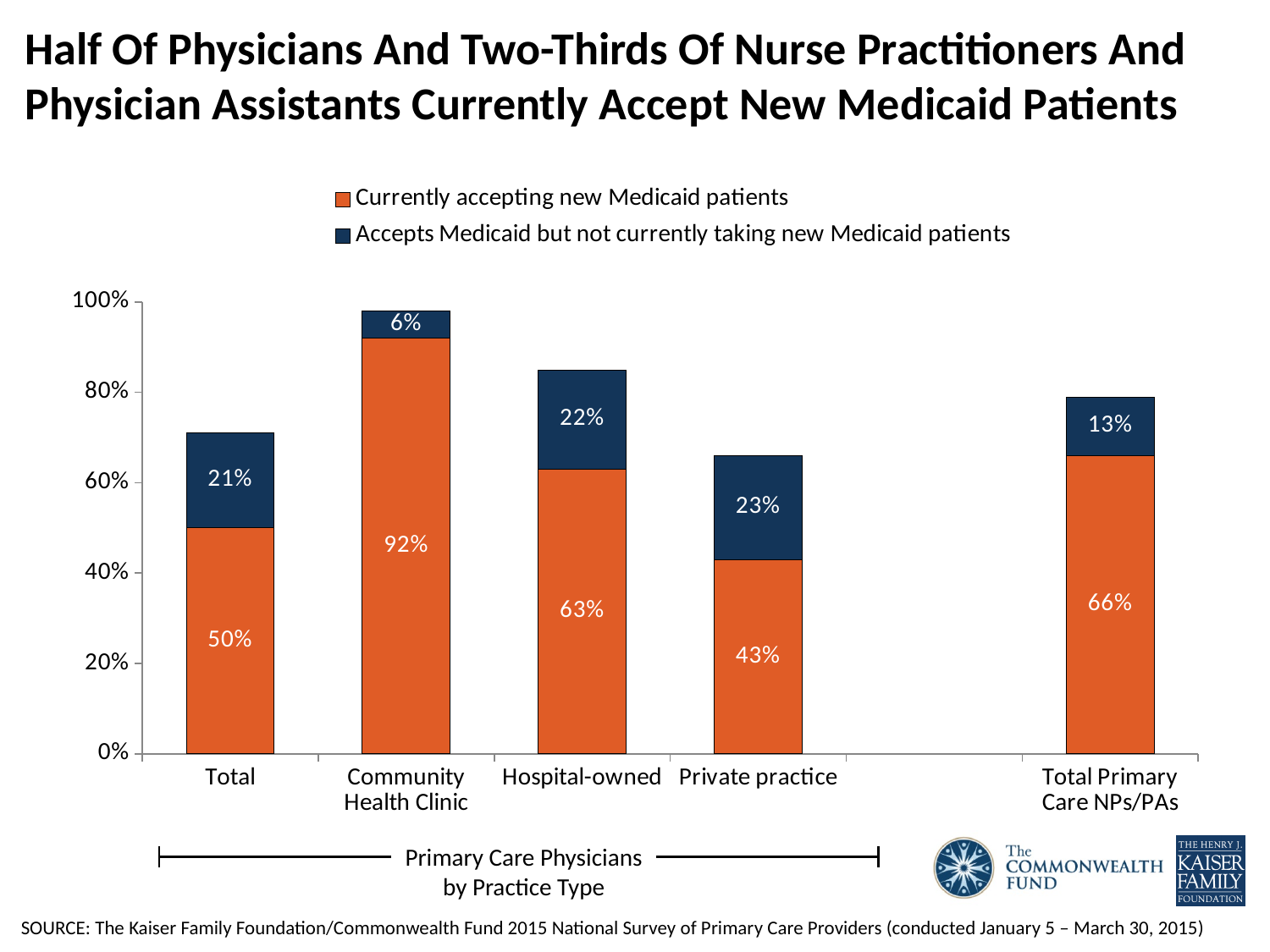
What is the value for Private practice in the 'Accepts Medicaid but not currently taking new Medicaid patients' series? 23% What percentage of Community Health Clinic physicians are currently accepting new Medicaid patients? 92% Which is larger: the 'Accepts Medicaid but not currently taking new Medicaid patients' value for Hospital-owned or for Total Primary Care NPs/PAs? Hospital-owned How many series does the legend list? 2 How many categories are shown on the x axis? 5 What is the combined total of the two segments for the Total bar? 71% Which category has the lowest share currently accepting new Medicaid patients? Private practice What is the difference between the Hospital-owned and Private practice values for currently accepting new Medicaid patients? 20% What kind of chart is shown on the slide? Stacked bar chart Which category has the highest share currently accepting new Medicaid patients? Community Health Clinic What percentage of Total Primary Care NPs/PAs are currently accepting new Medicaid patients? 66% What is the combined total of the two segments for the Community Health Clinic bar? 98%